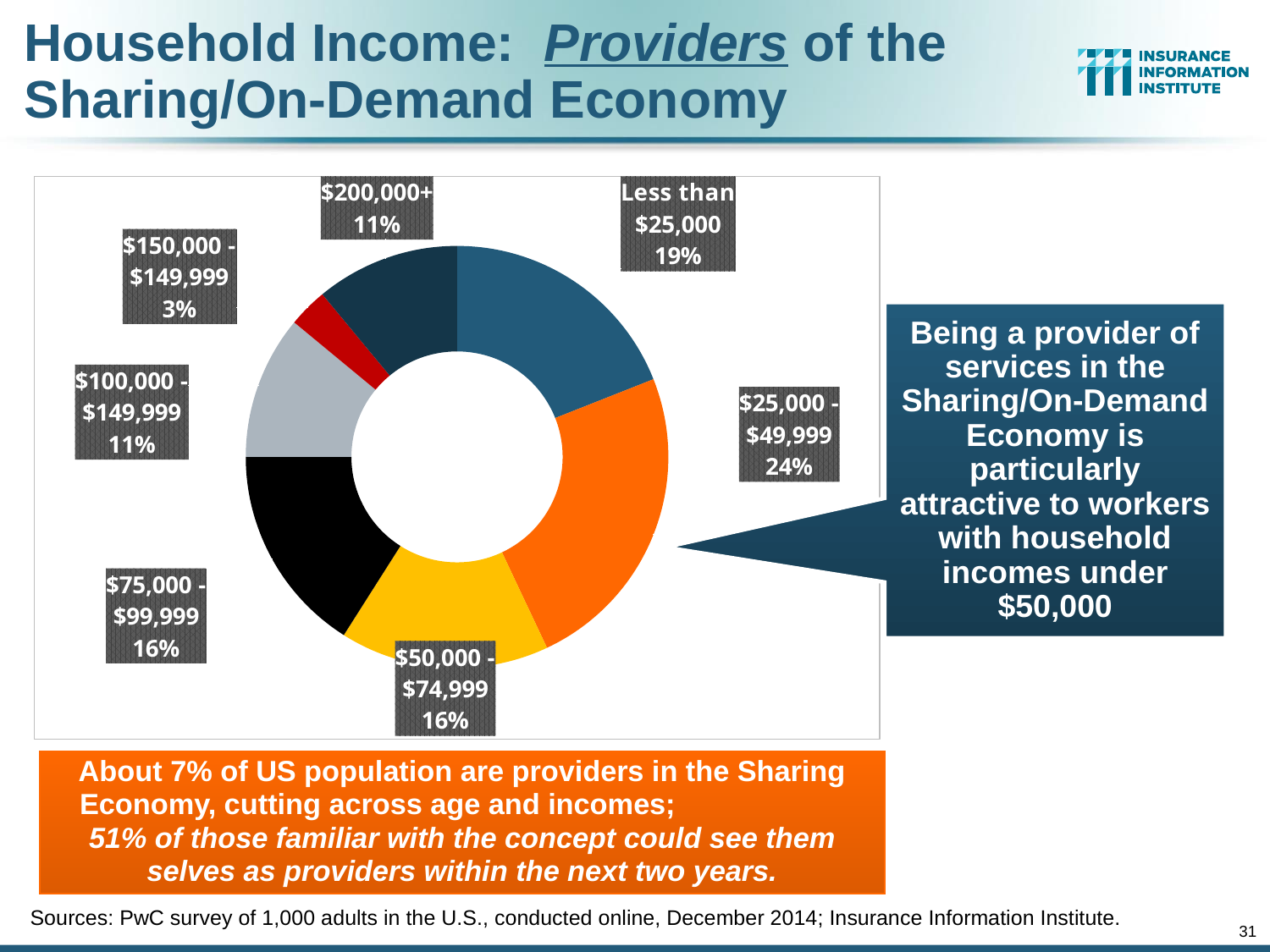
What share of providers have a household income of less than $25,000? 19% What share of providers have a household income of $75,000 - $99,999? 16% Which household income category has the smallest share of providers? $150,000 - $149,999 (3%) Which is larger: the share for $100,000 - $149,999 or the share for $75,000 - $99,999? $75,000 - $99,999 What is the combined share of providers with household incomes under $50,000? 43% What kind of chart is shown on the slide? Doughnut (pie) chart What share of providers have a household income of $200,000+? 11% How many household income categories are shown in the chart? 7 What share of providers have a household income of $25,000 - $49,999? 24% What is the difference in percentage points between the $25,000 - $49,999 category and the Less than $25,000 category? 5 percentage points What colour is the slice for the $25,000 - $49,999 category? Orange Which household income category has the largest share of providers? $25,000 - $49,999